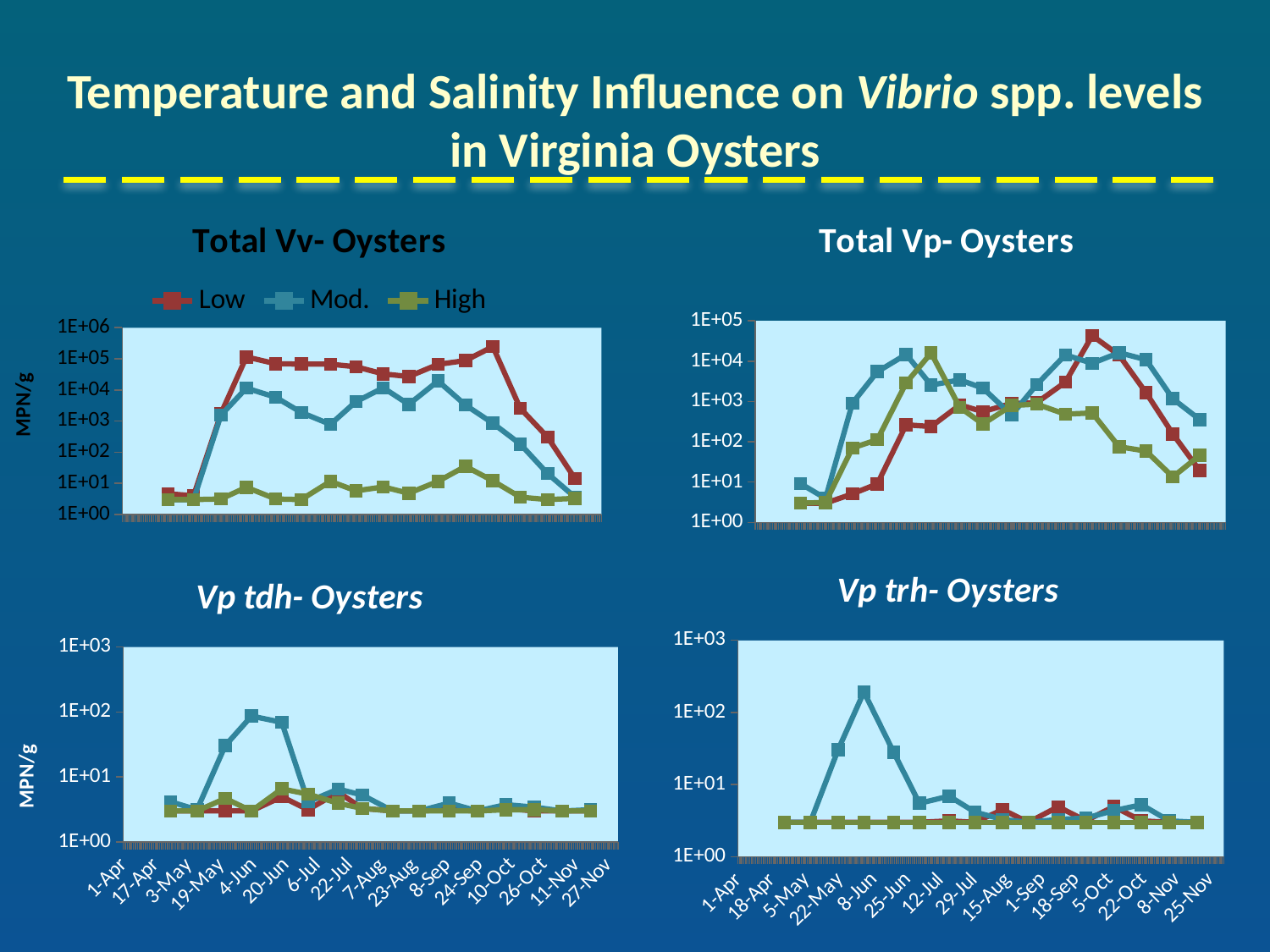
On the "Total Vv- Oysters" chart, which series reaches the highest value? Low How many series does the legend on the "Total Vv- Oysters" chart list? 3 On the "Total Vp- Oysters" chart, which series reaches the highest peak? Low What is the y-axis label shown for the "Total Vv- Oysters" chart? MPN/g On the "Total Vv- Oysters" chart, which series stays lowest through the summer months? High What are the legend entries on the "Total Vv- Oysters" chart? Low, Mod., High On the "Vp trh- Oysters" chart, does the Mod. series rise or fall between 8-Jun and 12-Jul? fall On the "Vp tdh- Oysters" chart, is the value for the Mod. series at 4-Jun greater or less than 1E+01? greater What kind of chart is the "Total Vv- Oysters" chart? line chart On the "Vp trh- Oysters" chart, is the value for the Mod. series at 8-Jun greater or less than 1E+02? greater What is the highest y-axis tick on the "Total Vp- Oysters" chart? 1E+05 On the "Vp tdh- Oysters" chart, which series reaches the highest value? Mod.